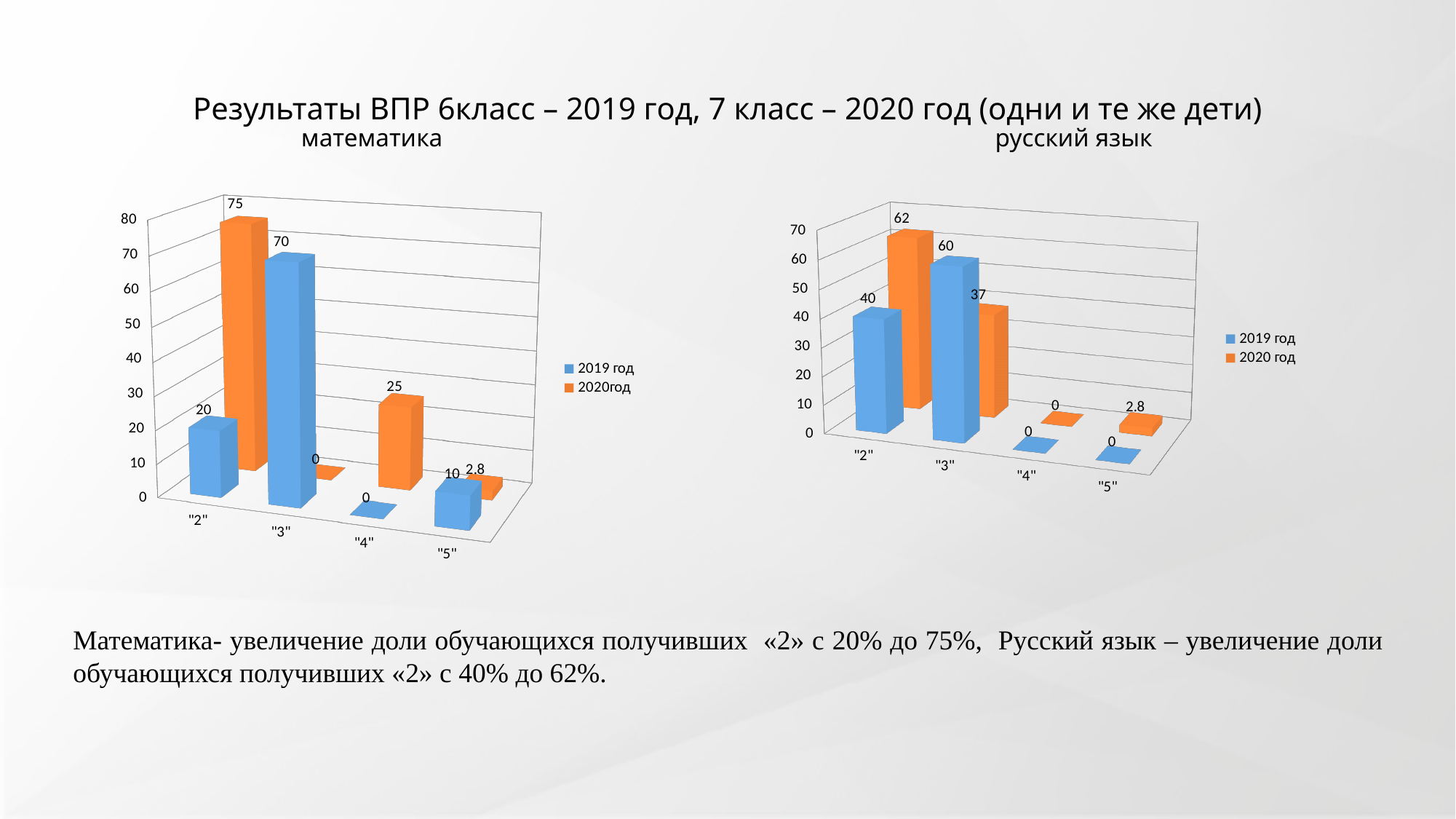
In the русский язык chart, what is the value for "3" in the 2019 год series? 60 How many categories are shown on the x axis of the русский язык chart? 4 How many series does the legend of the математика chart list? 2 In the русский язык chart, which is larger for "3": the 2019 год value or the 2020 год value? 2019 год In the математика chart, what is the value for "5" in the 2020 год series? 2.8 In the математика chart, what is the value for "3" in the 2019 год series? 70 What type of chart is the математика chart? Bar chart In the математика chart, what is the value for "2" in the 2020 год series? 75 In the математика chart, what is the difference between the 2020 год and 2019 год values for "2"? 55 In the русский язык chart, what is the difference between the 2019 год and 2020 год values for "3"? 23 In the русский язык chart, what is the value for "2" in the 2020 год series? 62 In the математика chart, which category has the highest value in the 2019 год series? "3"